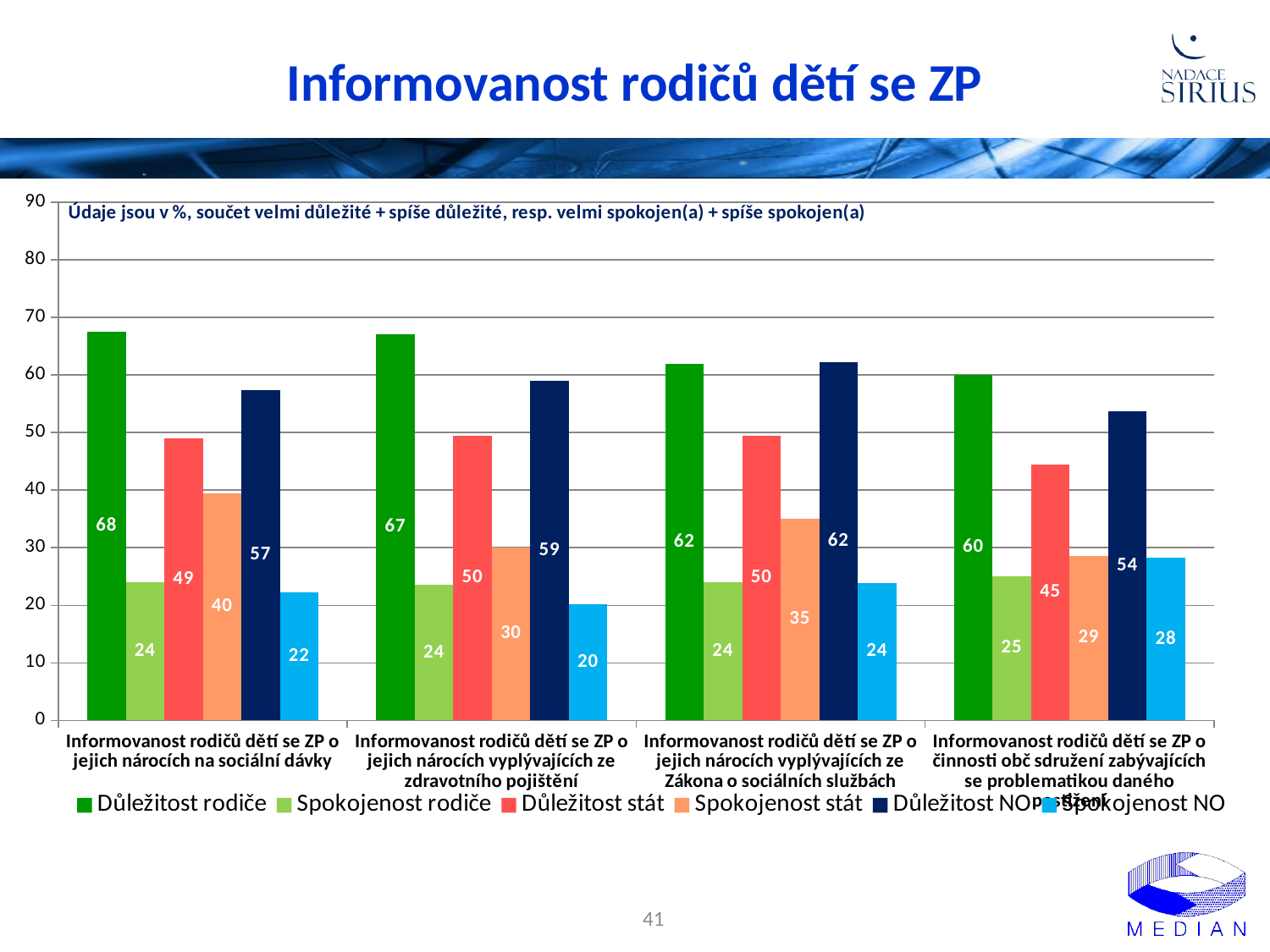
Which category has the highest value for Důležitost rodiče? Informovanost rodičů dětí se ZP o jejich nárocích na sociální dávky For 'Informovanost rodičů dětí se ZP o jejich nárocích vyplývajících ze zdravotního pojištění', which is larger: Důležitost stát or Spokojenost stát? Důležitost stát What is the value of Důležitost NO for 'Informovanost rodičů dětí se ZP o jejich nárocích vyplývajících ze Zákona o sociálních službách'? 62 What is the value of Spokojenost stát for 'Informovanost rodičů dětí se ZP o jejich nárocích vyplývajících ze zdravotního pojištění'? 30 Does the value of Důležitost rodiče rise or fall across the categories from left to right? fall What type of chart is shown on the slide? bar chart What is the value of Spokojenost NO for 'Informovanost rodičů dětí se ZP o činnosti obč sdružení zabývajících se problematikou daného postižení'? 28 What is the difference between Důležitost rodiče and Spokojenost rodiče for 'Informovanost rodičů dětí se ZP o jejich nárocích na sociální dávky'? 44 Which category has the lowest value for Spokojenost NO? Informovanost rodičů dětí se ZP o jejich nárocích vyplývajících ze zdravotního pojištění How many categories are shown on the x axis? 4 What is the value of Důležitost rodiče for 'Informovanost rodičů dětí se ZP o jejich nárocích na sociální dávky'? 68 How many series does the legend list? 6